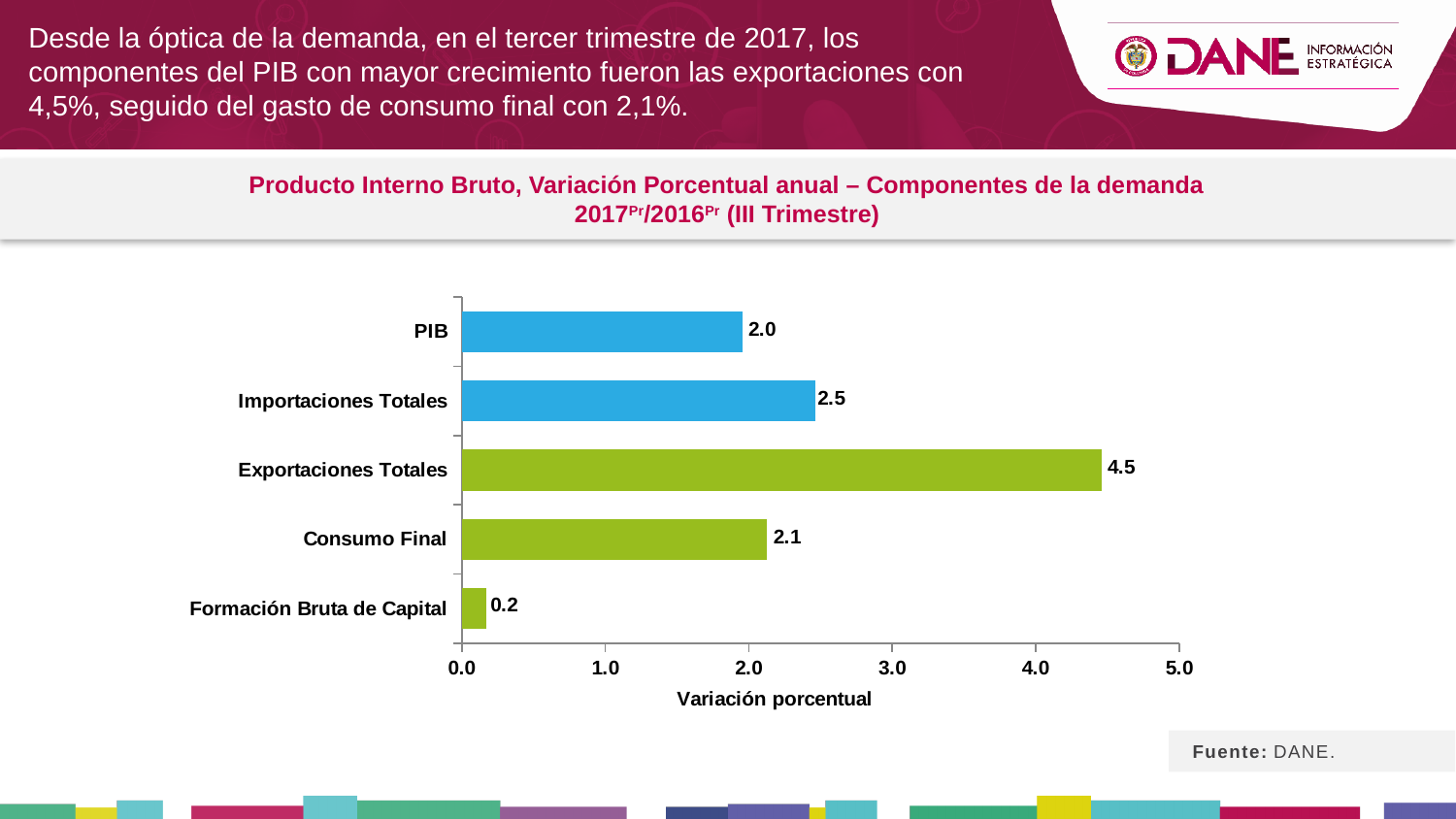
What is the value for Formación Bruta de Capital? 0.2 What is the difference between the values for Exportaciones Totales and Consumo Final? 2.4 What kind of chart is shown on the slide? bar chart Which category has the lowest value? Formación Bruta de Capital What is the label of the horizontal axis? Variación porcentual Is the value for Consumo Final greater or less than 3.0? less What is the value for PIB? 2.0 What is the value for Exportaciones Totales? 4.5 Which category has the highest value? Exportaciones Totales What is the value for Importaciones Totales? 2.5 How many categories are shown in the chart? 5 Which is larger, the value for Importaciones Totales or the value for PIB? Importaciones Totales